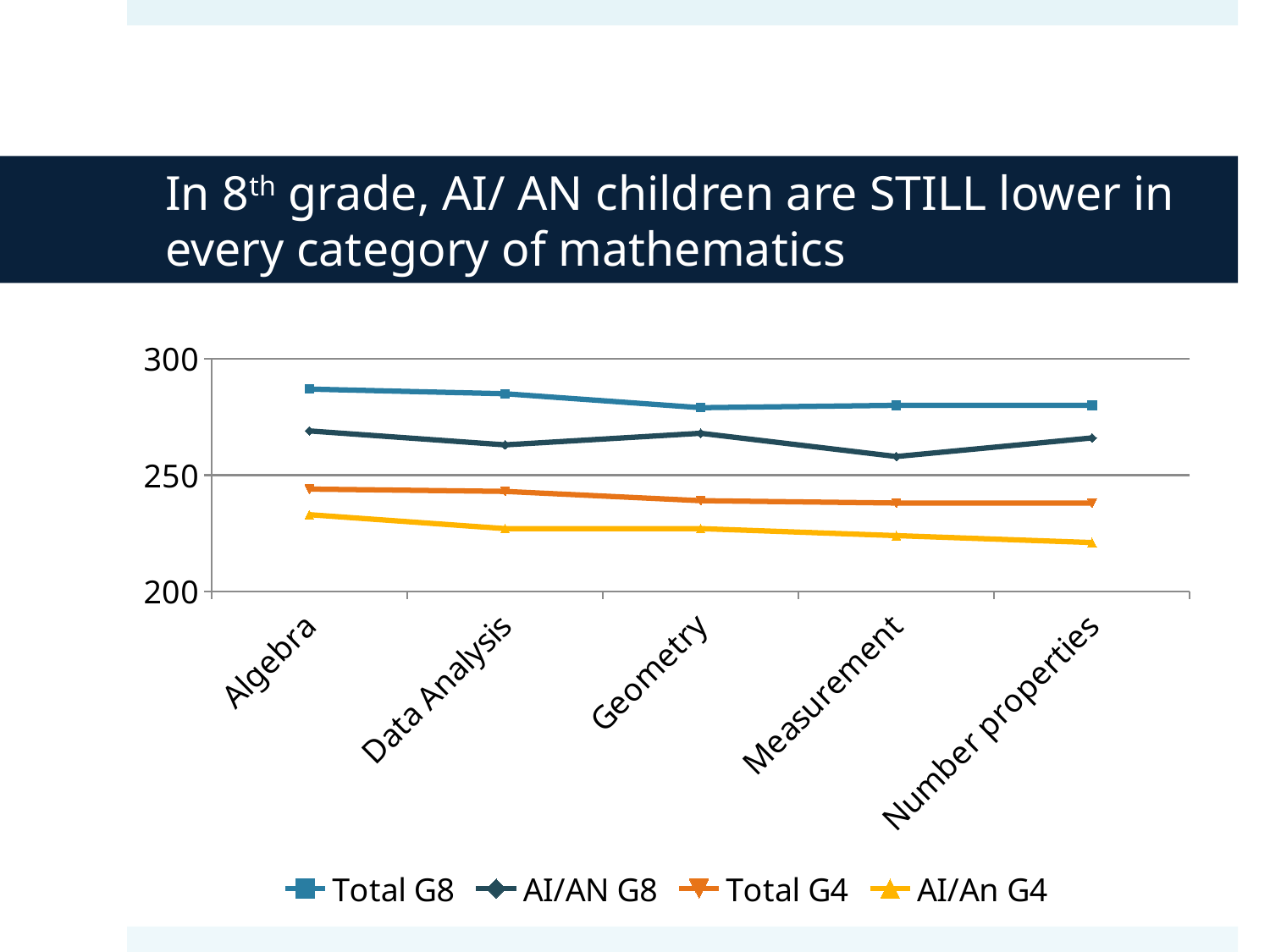
Do the AI/An G4 values generally rise or fall from Algebra to Number properties? fall Is the value for AI/AN G8 in Measurement greater or less than 250? greater In Algebra, which is larger: Total G8 or AI/AN G8? Total G8 How many series does the legend list? 4 In which category is the AI/AN G8 value lowest? Measurement How many mathematics categories are plotted along the x axis? 5 What kind of chart is shown on the slide? line chart In Geometry, which is larger: Total G4 or AI/An G4? Total G4 In which category is the AI/An G4 value highest? Algebra Is the value for Total G4 in Algebra greater or less than 250? less Is the value for AI/An G4 in Number properties greater or less than 250? less